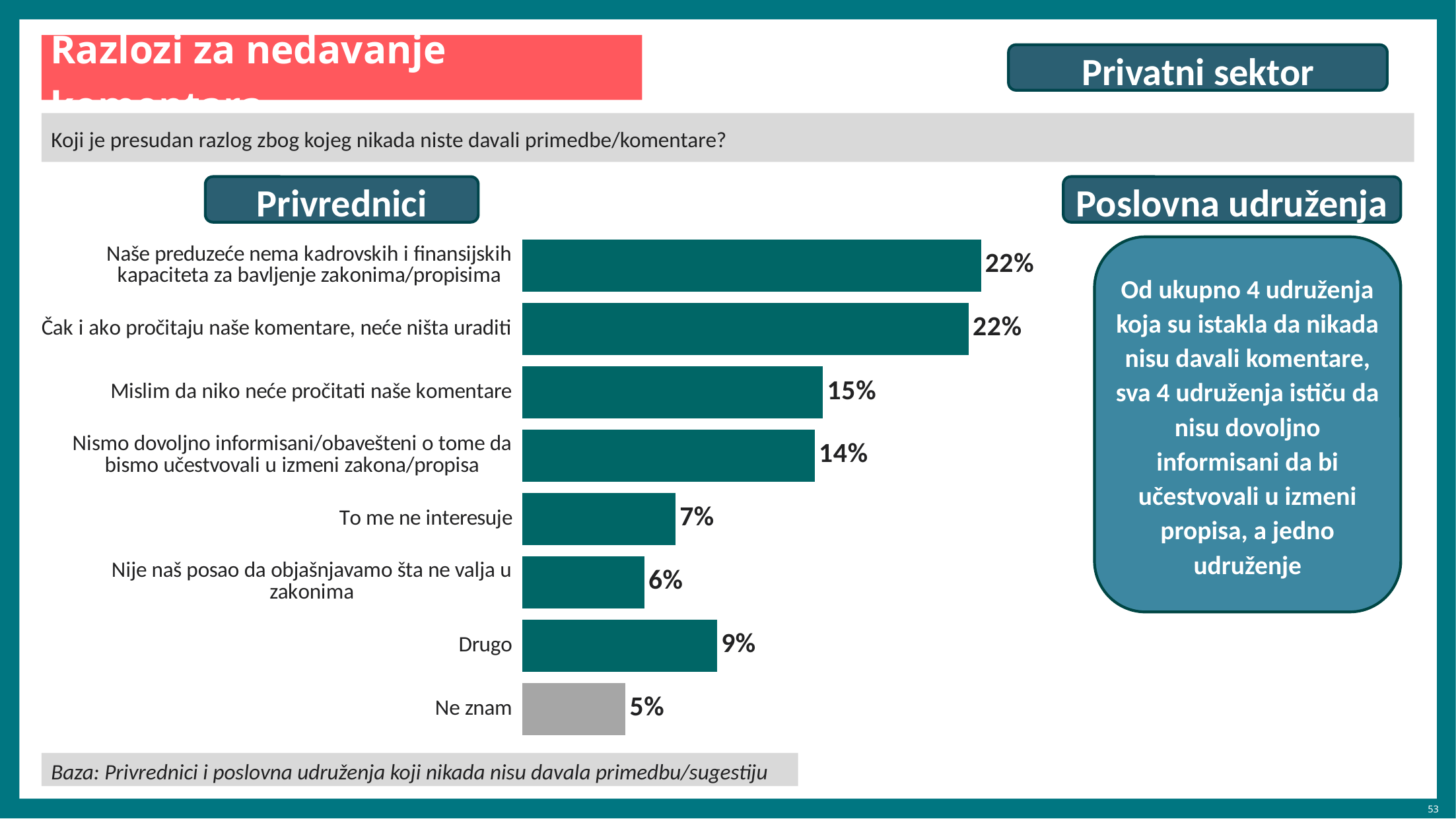
Which is larger: "Čak i ako pročitaju naše komentare, neće ništa uraditi" or "Mislim da niko neće pročitati naše komentare"? Čak i ako pročitaju naše komentare, neće ništa uraditi How many categories does the chart show? 8 What is the difference between "Mislim da niko neće pročitati naše komentare" and "To me ne interesuje"? 8% What is the value for "Nismo dovoljno informisani/obavešteni o tome da bismo učestvovali u izmeni zakona/propisa"? 14% What is the difference between "Drugo" and "Ne znam"? 4% Which is larger: "Drugo" or "Nije naš posao da objašnjavamo šta ne valja u zakonima"? Drugo Which bar is shown in a different (grey) colour from the others? Ne znam What is the value for "To me ne interesuje"? 7% What is the value for "Drugo"? 9% Which category has the lowest value? Ne znam What is the value for "Mislim da niko neće pročitati naše komentare"? 15% What kind of chart is shown on the slide? Bar chart